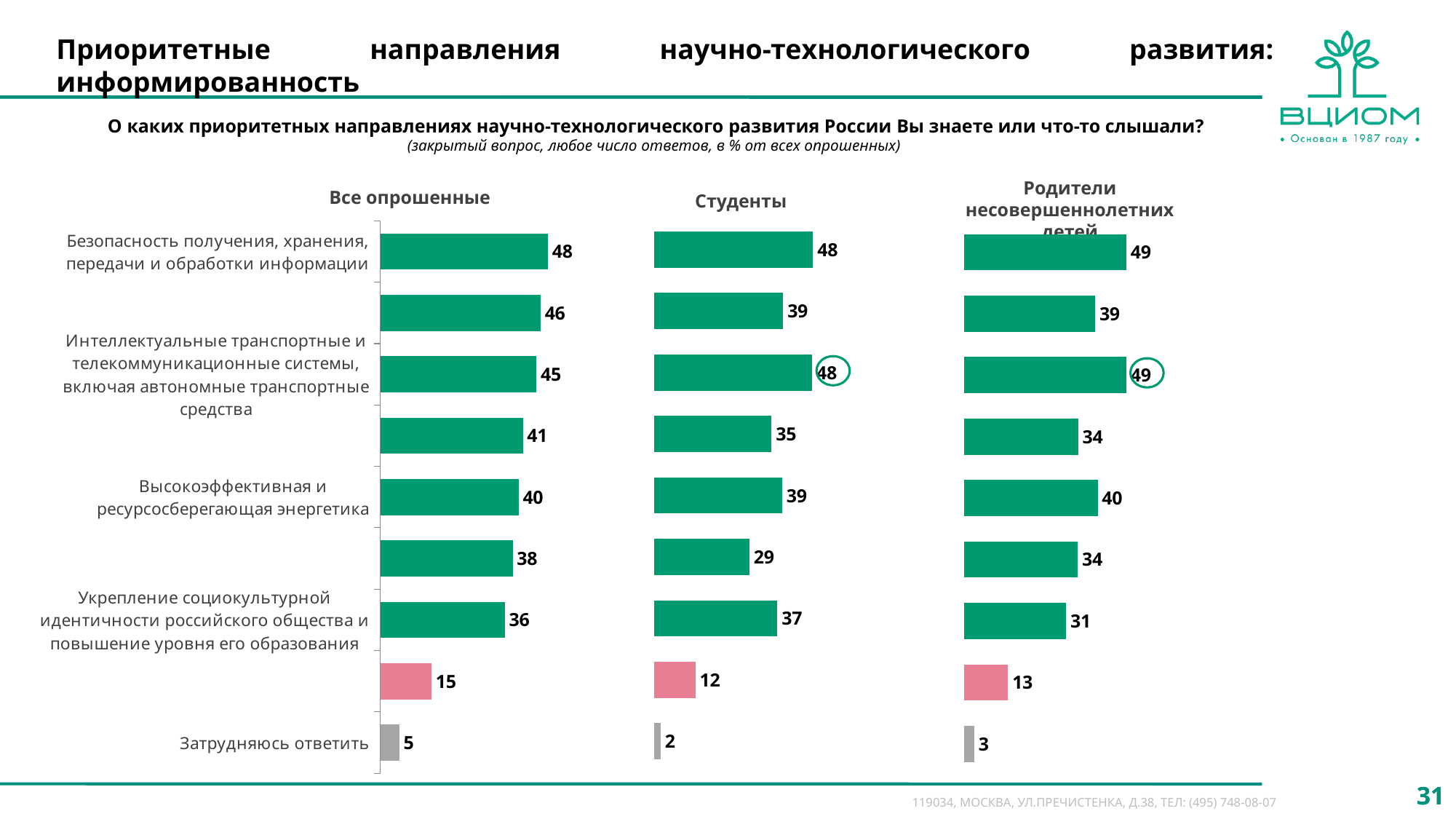
In the chart 'Студенты', which is larger: 'Высокоэффективная и ресурсосберегающая энергетика' or 'Укрепление социокультурной идентичности российского общества и повышение уровня его образования'? Высокоэффективная и ресурсосберегающая энергетика In the chart 'Все опрошенные', which category has the lowest value? Затрудняюсь ответить How many separate charts are shown on the slide? 3 In the chart 'Все опрошенные', what is the value for 'Укрепление социокультурной идентичности российского общества и повышение уровня его образования'? 36 In the chart 'Студенты', what is the value for 'Затрудняюсь ответить'? 2 How many bars does the chart 'Студенты' contain? 9 In the chart 'Студенты', what is the value for 'Интеллектуальные транспортные и телекоммуникационные системы, включая автономные транспортные средства'? 48 What type of chart is used for 'Все опрошенные'? Bar chart In the chart 'Родители несовершеннолетних детей', what is the difference between 'Безопасность получения, хранения, передачи и обработки информации' and 'Укрепление социокультурной идентичности российского общества и повышение уровня его образования'? 18 In the chart 'Родители несовершеннолетних детей', what is the value for 'Высокоэффективная и ресурсосберегающая энергетика'? 40 In the chart 'Все опрошенные', what is the highest value shown? 48 In the chart 'Все опрошенные', what is the value for 'Безопасность получения, хранения, передачи и обработки информации'? 48